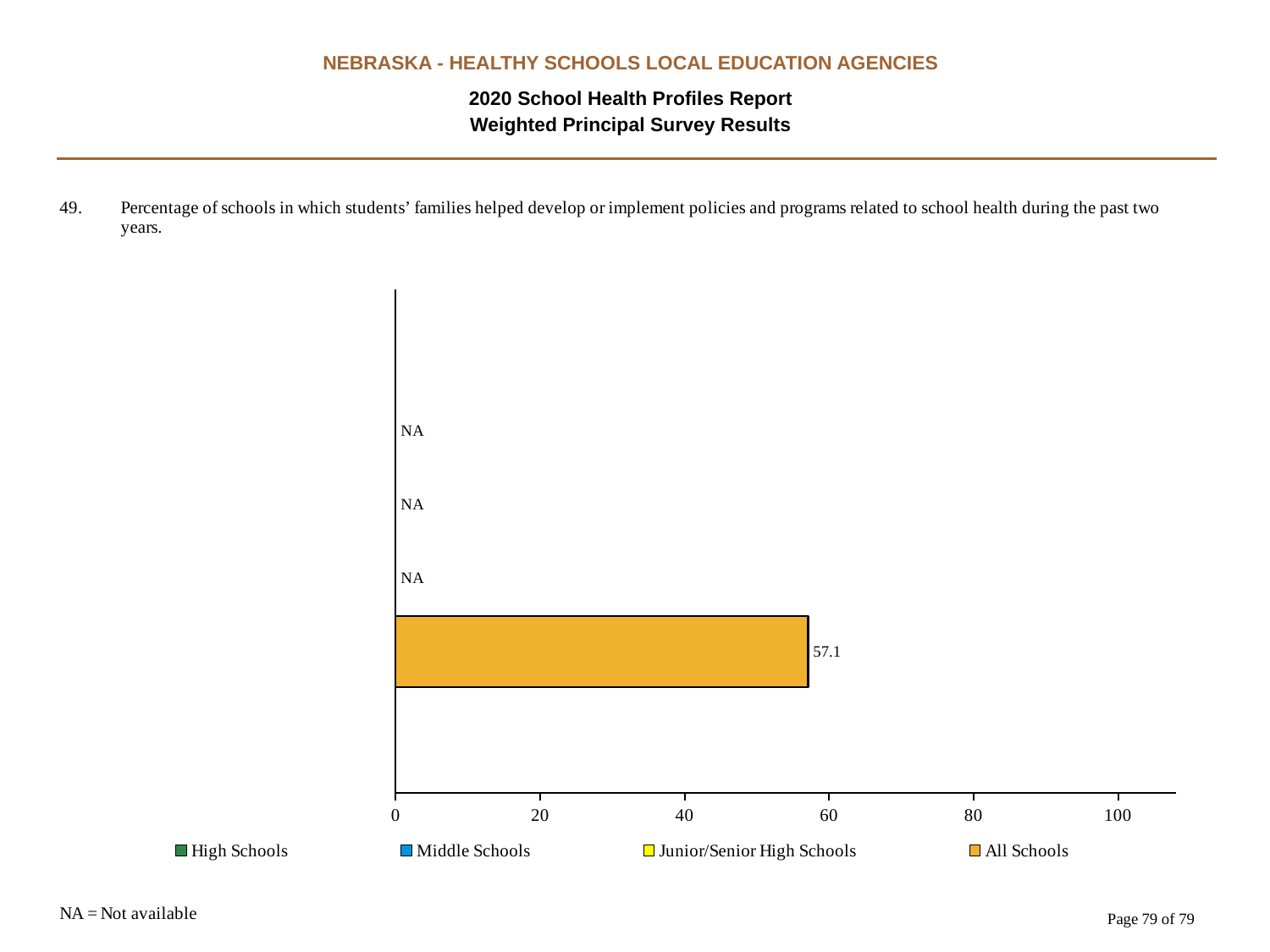
Is the value for All Schools greater or less than 40? greater What is shown for Middle Schools? NA What is the maximum value shown on the x axis? 100 Is the value for All Schools greater or less than 60? less What is shown for Junior/Senior High Schools? NA What is shown for High Schools? NA What kind of chart is shown on the slide? bar chart What does NA stand for according to the slide? Not available How many series have a plotted bar with a value? 1 What is the value for All Schools? 57.1 How many series does the legend list? 4